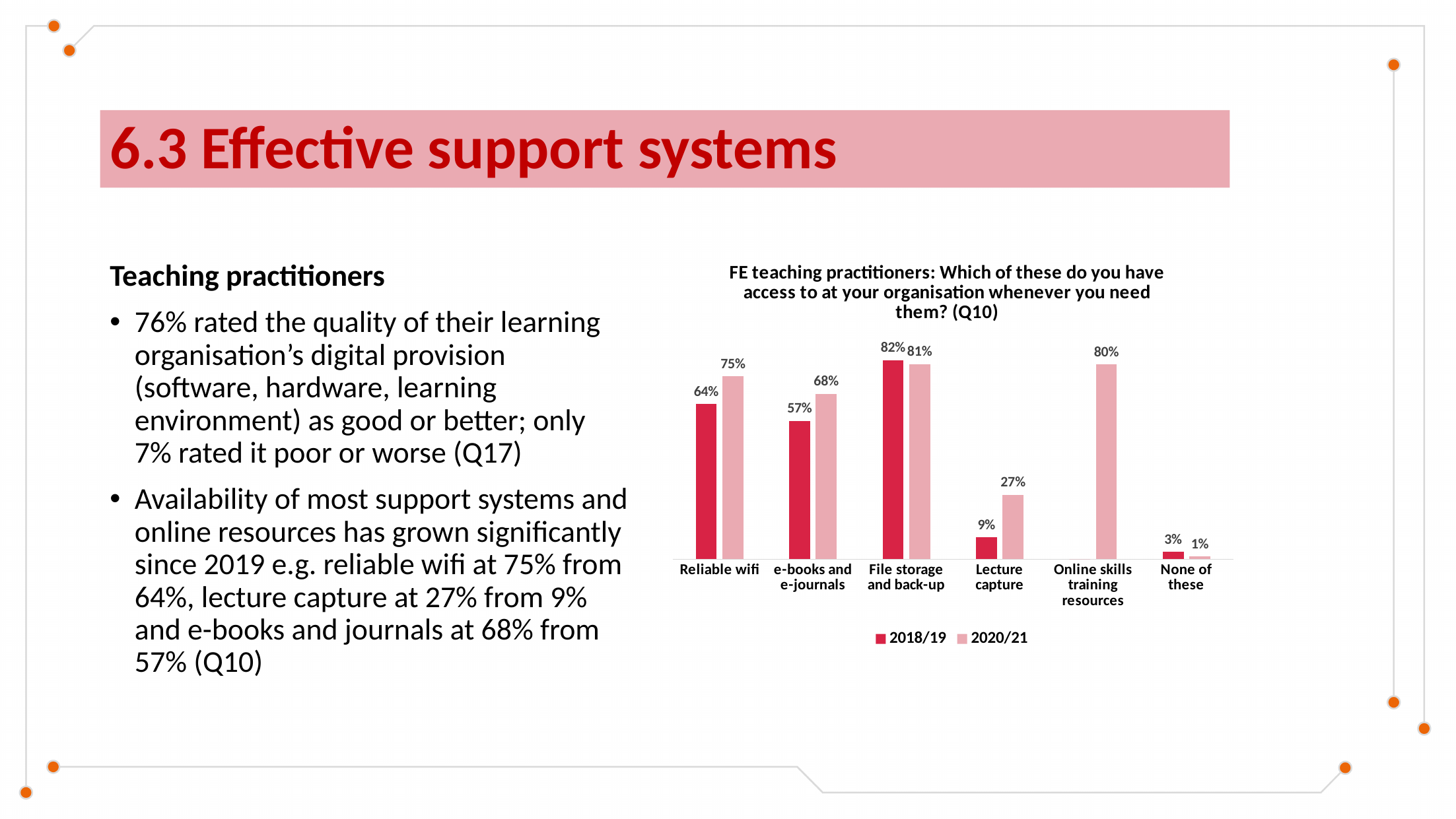
Which is larger for File storage and back-up: the 2018/19 value or the 2020/21 value? 2018/19 How many categories are shown on the x axis? 6 What is the difference between the 2020/21 and 2018/19 values for e-books and e-journals? 11% Which category has the lowest 2020/21 value? None of these How many series does the legend list? 2 What is the difference between the 2020/21 and 2018/19 values for Lecture capture? 18% What is the 2018/19 value for Lecture capture? 9% What is the 2020/21 value for Online skills training resources? 80% Which category has the highest 2018/19 value? File storage and back-up Which series is shown in the darker red colour? 2018/19 What is the 2020/21 value for Reliable wifi? 75% What kind of chart is shown on the slide? Bar chart